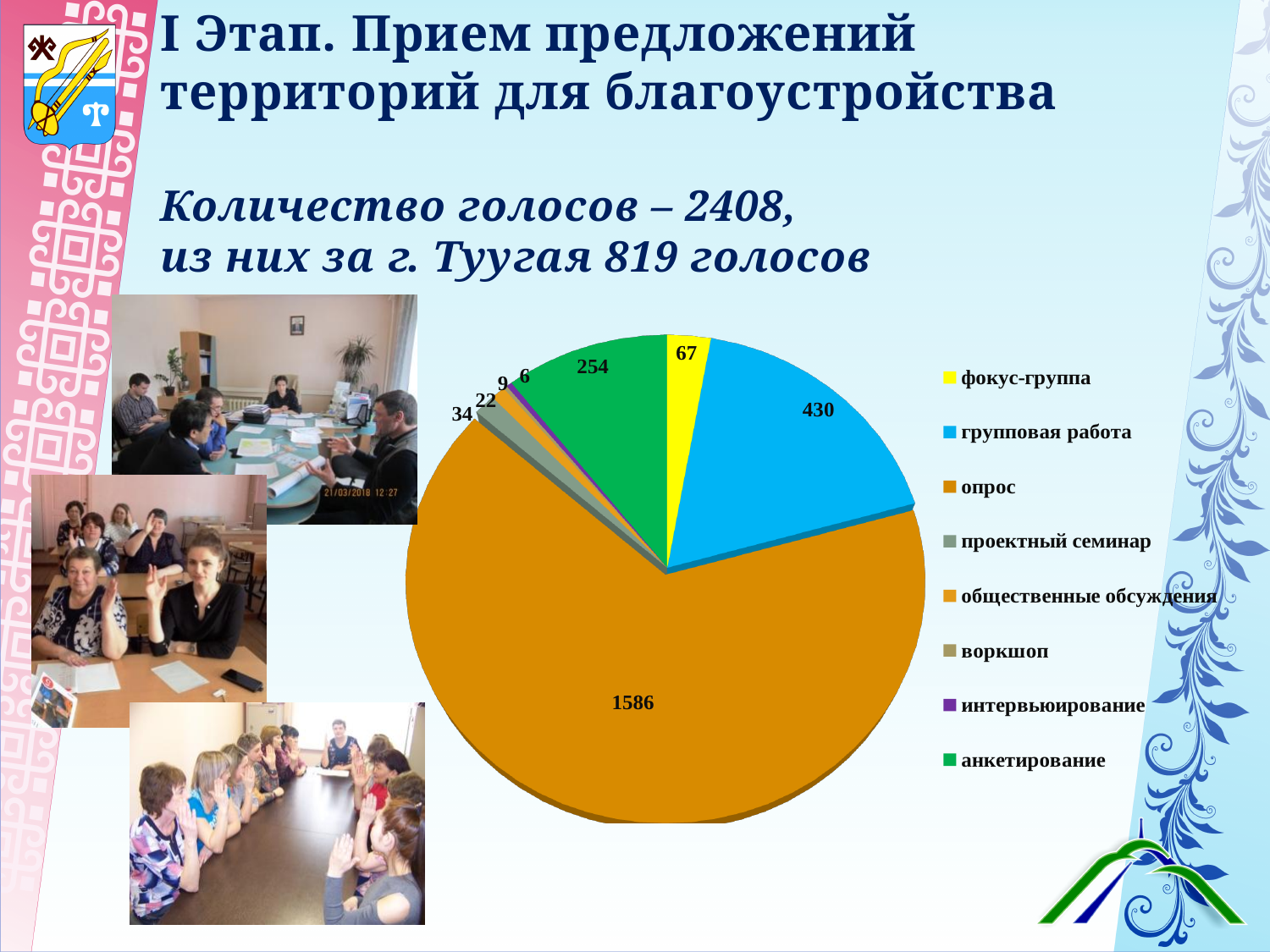
What is the value of the групповая работа slice in the pie chart? 430 What is the difference between the опрос and групповая работа values in the pie chart? 1156 Which category has the largest slice in the pie chart? опрос Which is larger in the pie chart, анкетирование or фокус-группа? анкетирование What is the value of the анкетирование slice in the pie chart? 254 How many slices does the pie chart have? 8 Which category has the smallest slice in the pie chart? воркшоп What is the value of the фокус-группа slice in the pie chart? 67 What colour is the опрос slice in the pie chart? orange What kind of chart is shown on the slide? pie chart How many entries does the legend of the pie chart list? 8 What is the value of the опрос slice in the pie chart? 1586